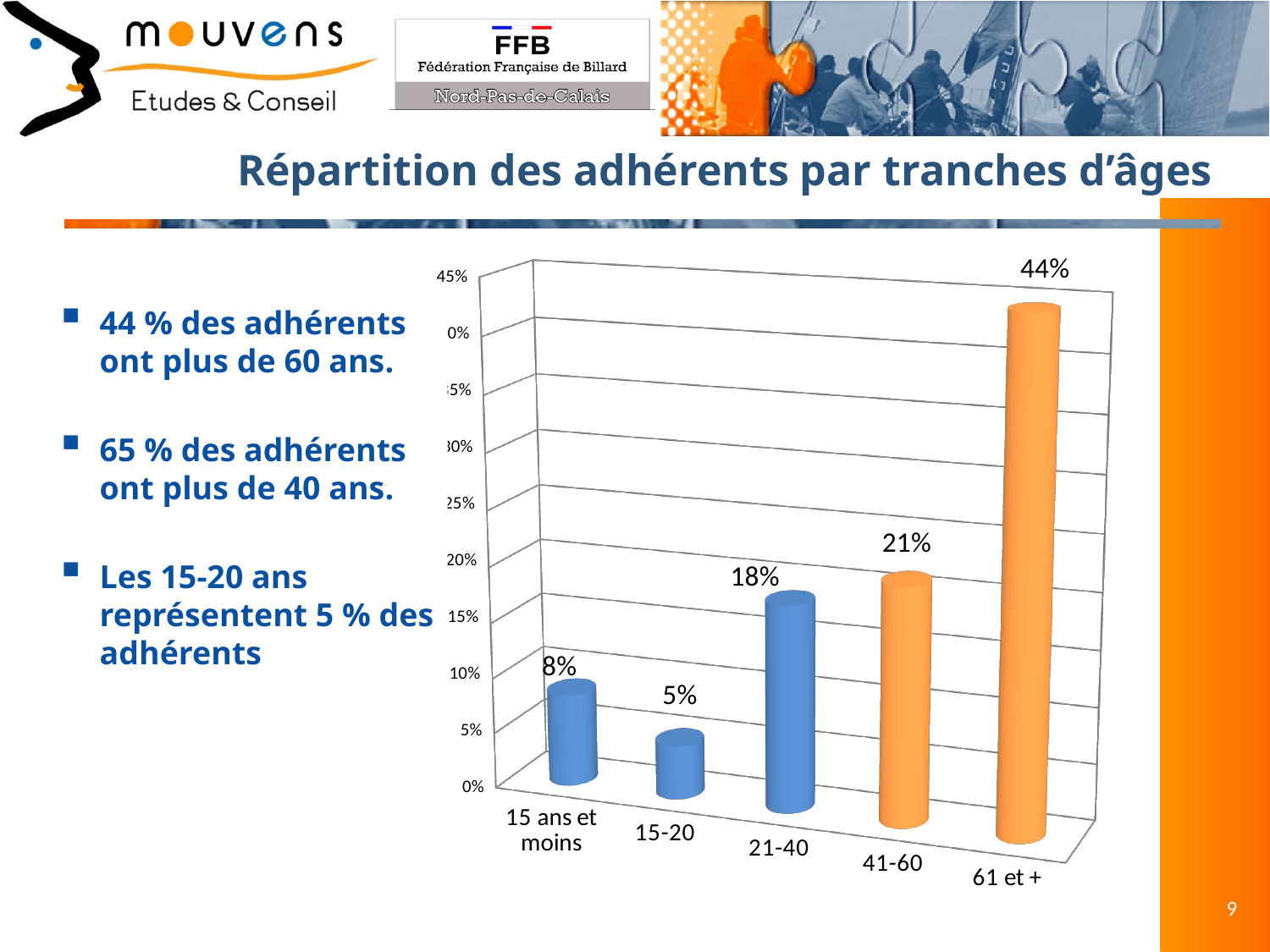
Which is larger, the value for 21-40 or the value for 15 ans et moins? 21-40 What is the value for the 61 et + age group? 44% Is the value for 41-60 greater or less than 20%? greater What is the value for the 15-20 age group? 5% What is the difference between the values for 61 et + and 41-60? 23% What is the value for the 21-40 age group? 18% Which age group has the lowest share of members? 15-20 What is the total of the values for 41-60 and 61 et +? 65% How many age groups are shown on the chart? 5 What kind of chart is shown on the slide? bar chart What is the value for the 15 ans et moins age group? 8% Which age group has the highest share of members? 61 et +